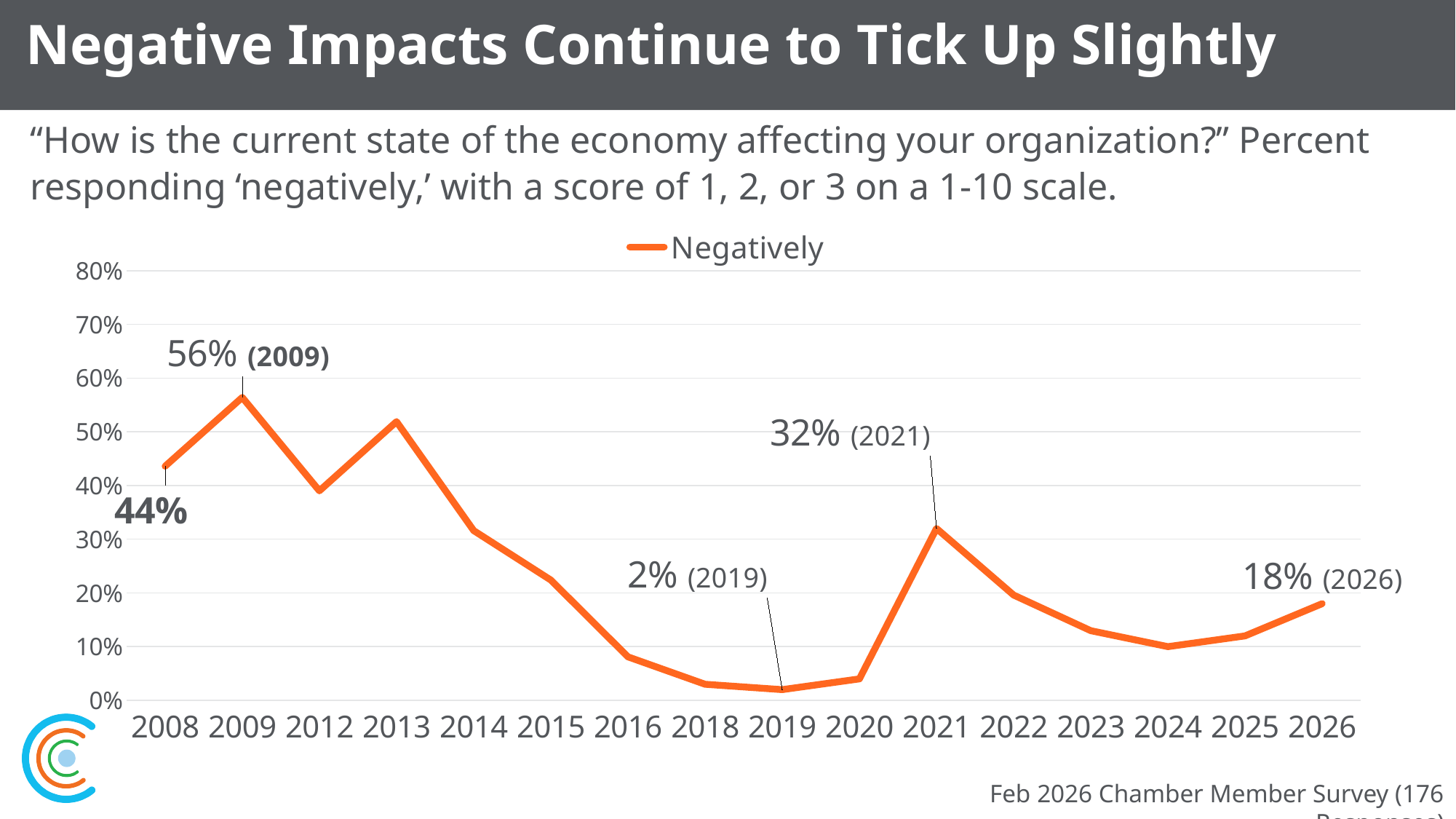
What is the value for 2021? 32% What is the value for 2009? 56% How many years are plotted on the x axis? 16 What is the value for 2026? 18% What is the value for 2019? 2% What is the difference between the values for 2009 and 2026? 38% Which year has the highest value? 2009 Which year has the lowest value? 2019 What is the value for 2008? 44% What kind of chart is shown on the slide? line chart Which is larger, the value for 2021 or the value for 2026? 2021 Is the value for 2013 greater or less than 40%? greater